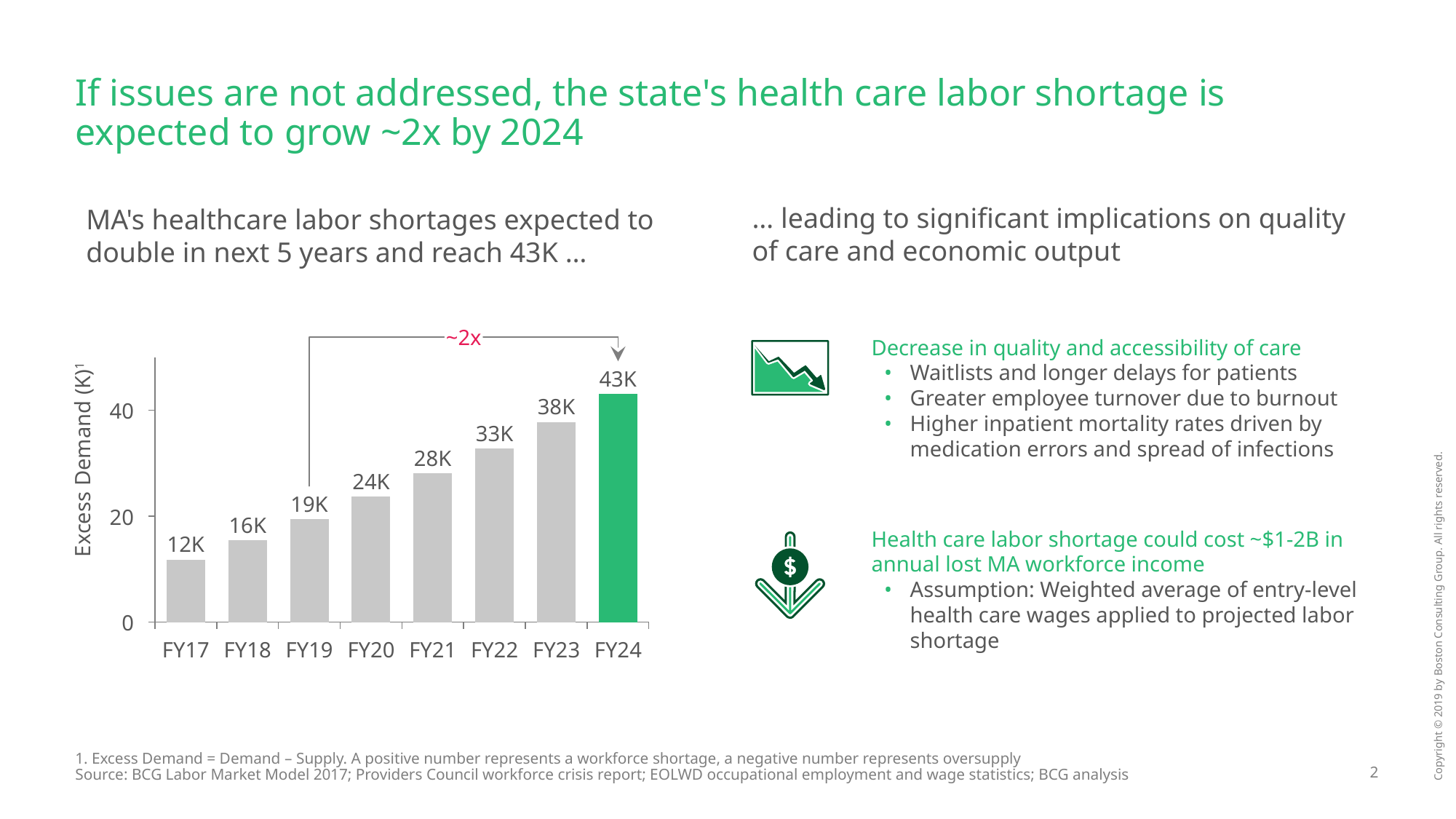
Which has a larger excess demand, FY20 or FY18? FY20 Which fiscal year has the lowest excess demand? FY17 What is the excess demand value for FY21? 28K What kind of chart is used to show excess demand by fiscal year? Bar chart What is the excess demand value for FY19? 19K What is the difference in excess demand between FY24 and FY19? 24K Which fiscal year has the highest excess demand? FY24 What is the excess demand value for FY24? 43K Do the excess demand values rise or fall from FY17 to FY24? Rise Is the value for FY22 greater or less than 20? greater What is the difference in excess demand between FY23 and FY22? 5K How many fiscal years are shown on the x axis of the chart? 8